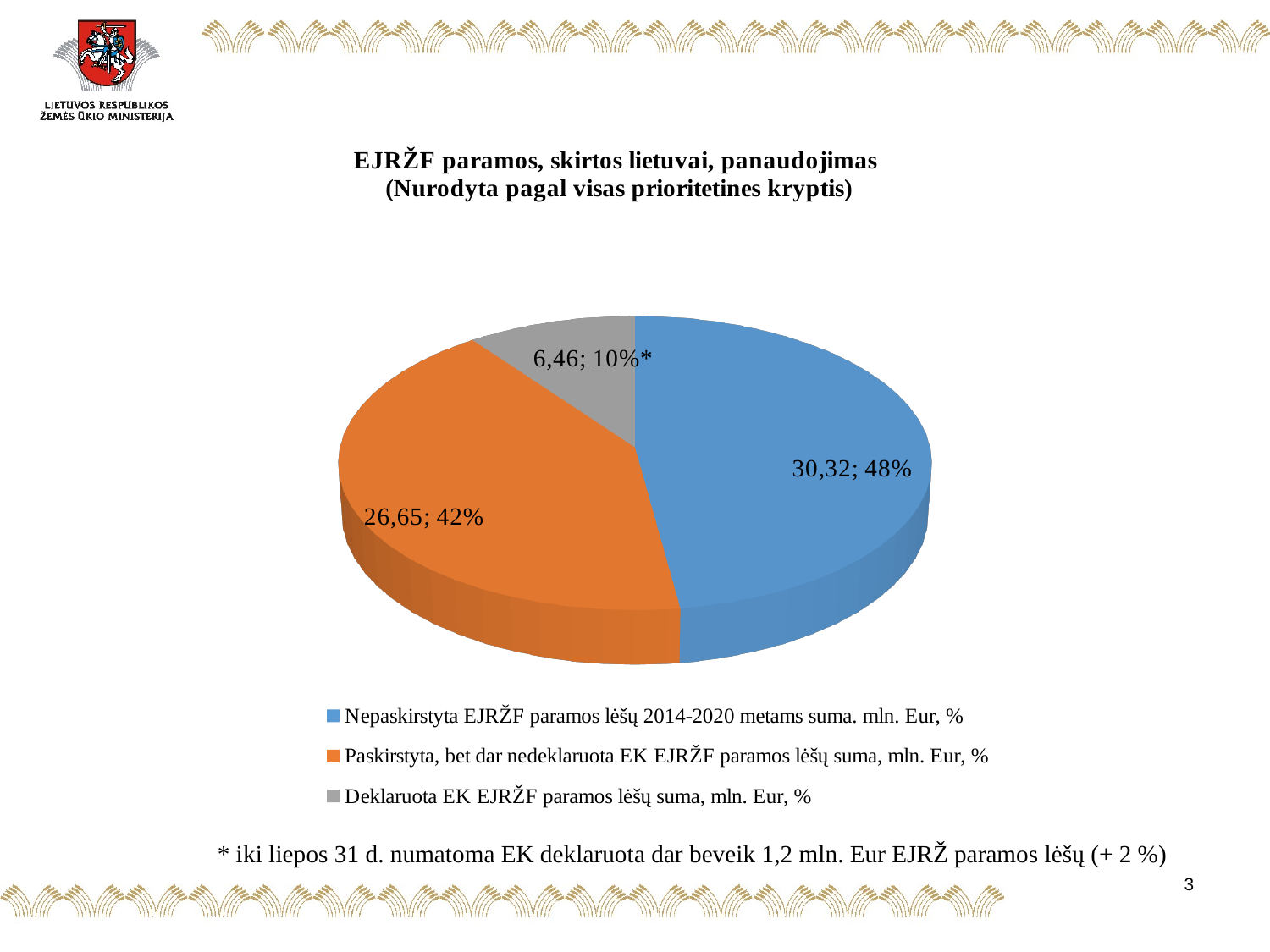
How many entries does the legend list? 3 What value in mln. Eur is shown for 'Deklaruota EK EJRŽF paramos lėšų suma'? 6,46 What value in mln. Eur is shown for 'Nepaskirstyta EJRŽF paramos lėšų 2014-2020 metams suma'? 30,32 What is the difference in mln. Eur between 'Nepaskirstyta EJRŽF paramos lėšų 2014-2020 metams suma' and 'Paskirstyta, bet dar nedeklaruota EK EJRŽF paramos lėšų suma'? 3,67 Which colour represents 'Deklaruota EK EJRŽF paramos lėšų suma' in the pie chart? grey Which category has the largest slice of the pie? Nepaskirstyta EJRŽF paramos lėšų 2014-2020 metams suma How many slices does the pie chart have? 3 What kind of chart is shown on the slide? pie chart What share of the pie does 'Deklaruota EK EJRŽF paramos lėšų suma' represent? 10% What share of the pie does 'Nepaskirstyta EJRŽF paramos lėšų 2014-2020 metams suma' represent? 48% What value in mln. Eur is shown for 'Paskirstyta, bet dar nedeklaruota EK EJRŽF paramos lėšų suma'? 26,65 Which category has the smallest slice of the pie? Deklaruota EK EJRŽF paramos lėšų suma